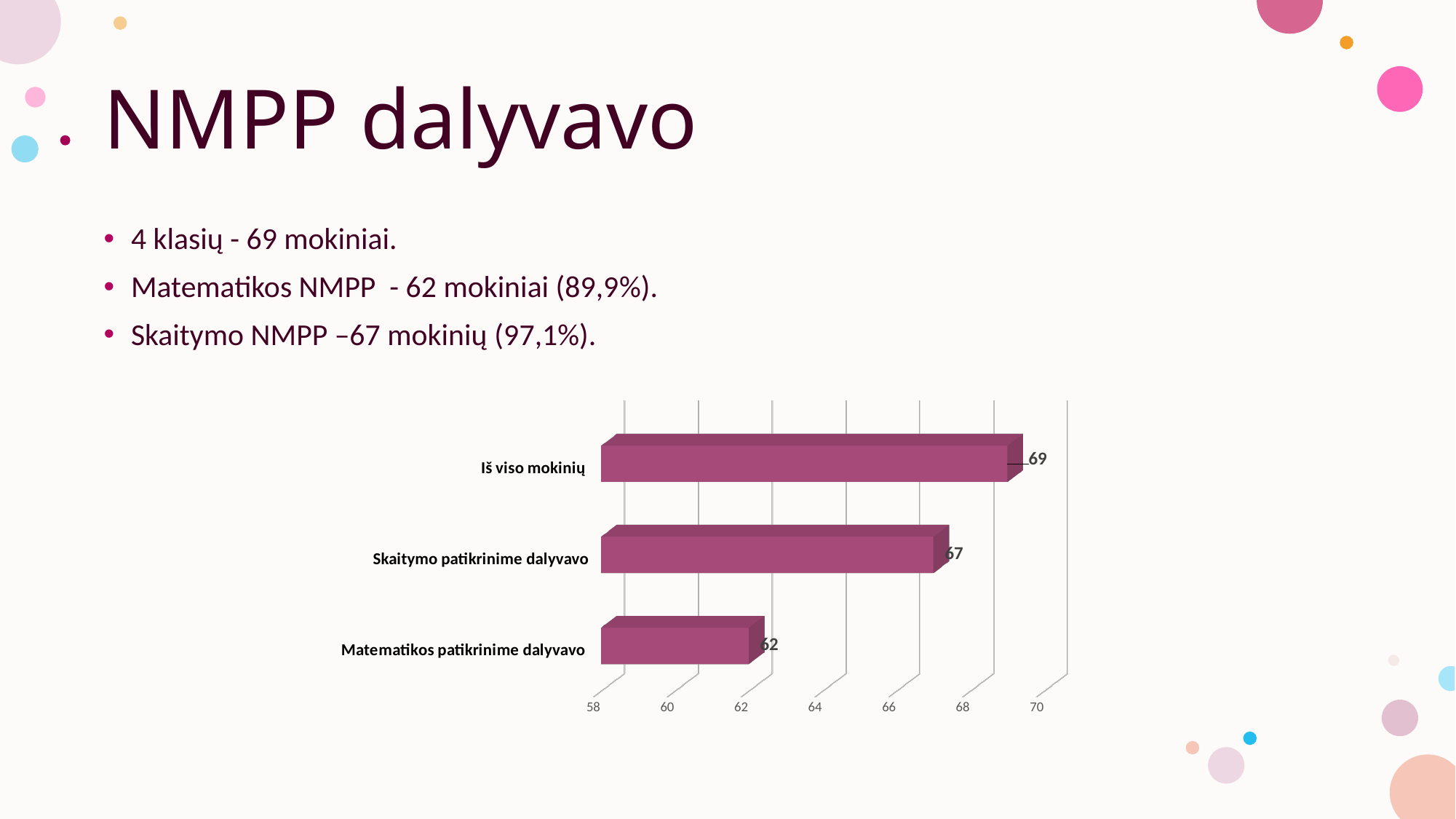
What is the difference between "Skaitymo patikrinime dalyvavo" and "Matematikos patikrinime dalyvavo"? 5 What is the highest value shown on the chart's axis? 70 What is the value for "Matematikos patikrinime dalyvavo"? 62 How many categories are shown in the chart? 3 Which category has the highest value? Iš viso mokinių What kind of chart is shown on the slide? Bar chart Which is larger: "Skaitymo patikrinime dalyvavo" or "Matematikos patikrinime dalyvavo"? Skaitymo patikrinime dalyvavo Is the value for "Skaitymo patikrinime dalyvavo" greater or less than 64? greater What is the value for "Iš viso mokinių"? 69 What is the value for "Skaitymo patikrinime dalyvavo"? 67 What is the difference between "Iš viso mokinių" and "Matematikos patikrinime dalyvavo"? 7 Which category has the lowest value? Matematikos patikrinime dalyvavo